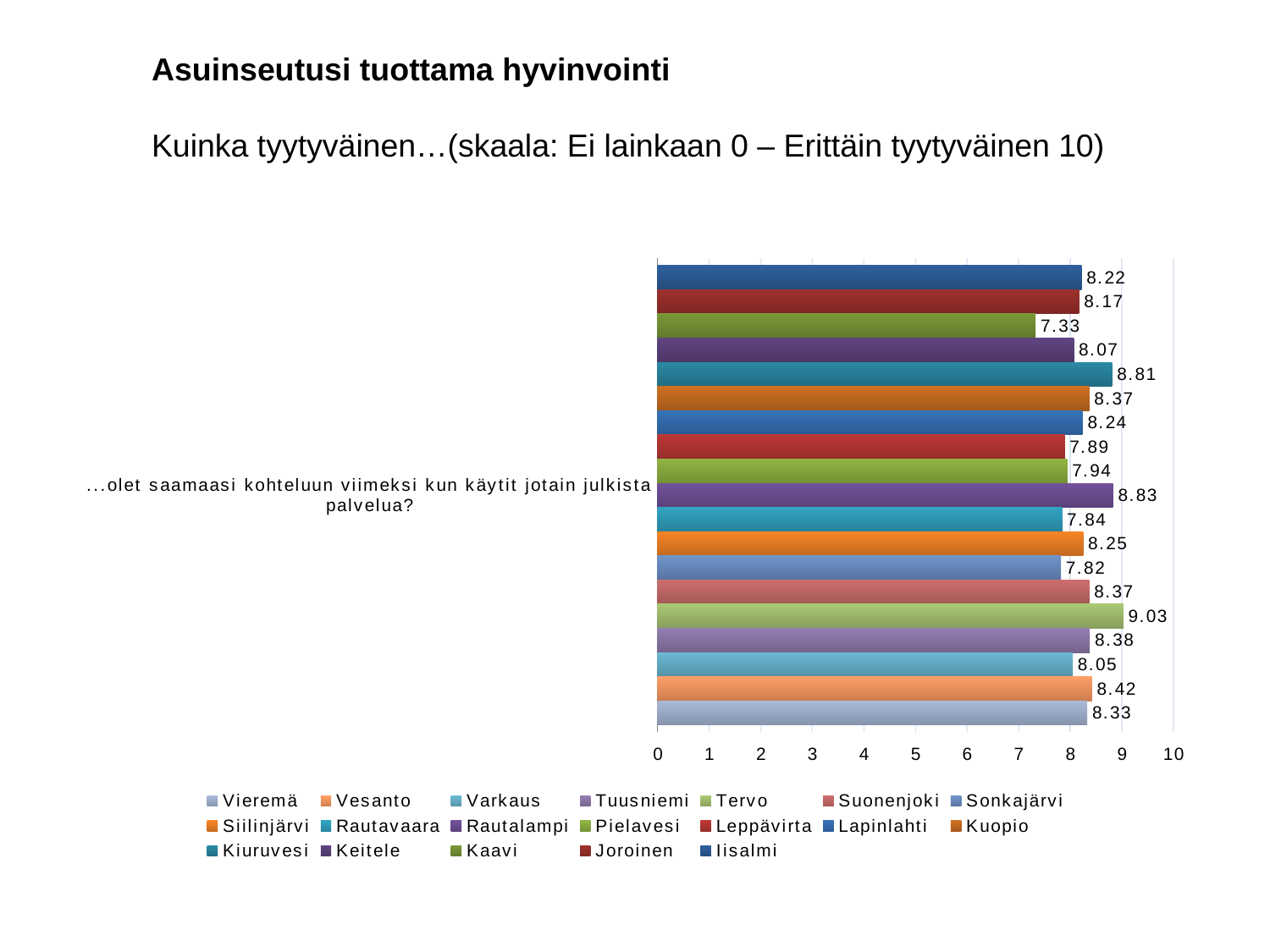
What is the value for Vieremä? 8.33 How many series does the legend list? 19 Which is larger, the value for Rautalampi or the value for Kiuruvesi? Rautalampi What is the difference between the values for Vesanto and Varkaus? 0.37 Which municipality has the lowest value? Kaavi Which municipality has the highest value? Tervo What is the value for Iisalmi? 8.22 What is the value for Kaavi? 7.33 What is the value for Tervo? 9.03 What is the difference between the highest value (Tervo) and the lowest value (Kaavi)? 1.70 What kind of chart is shown on the slide? bar chart What is the maximum value shown on the horizontal axis? 10